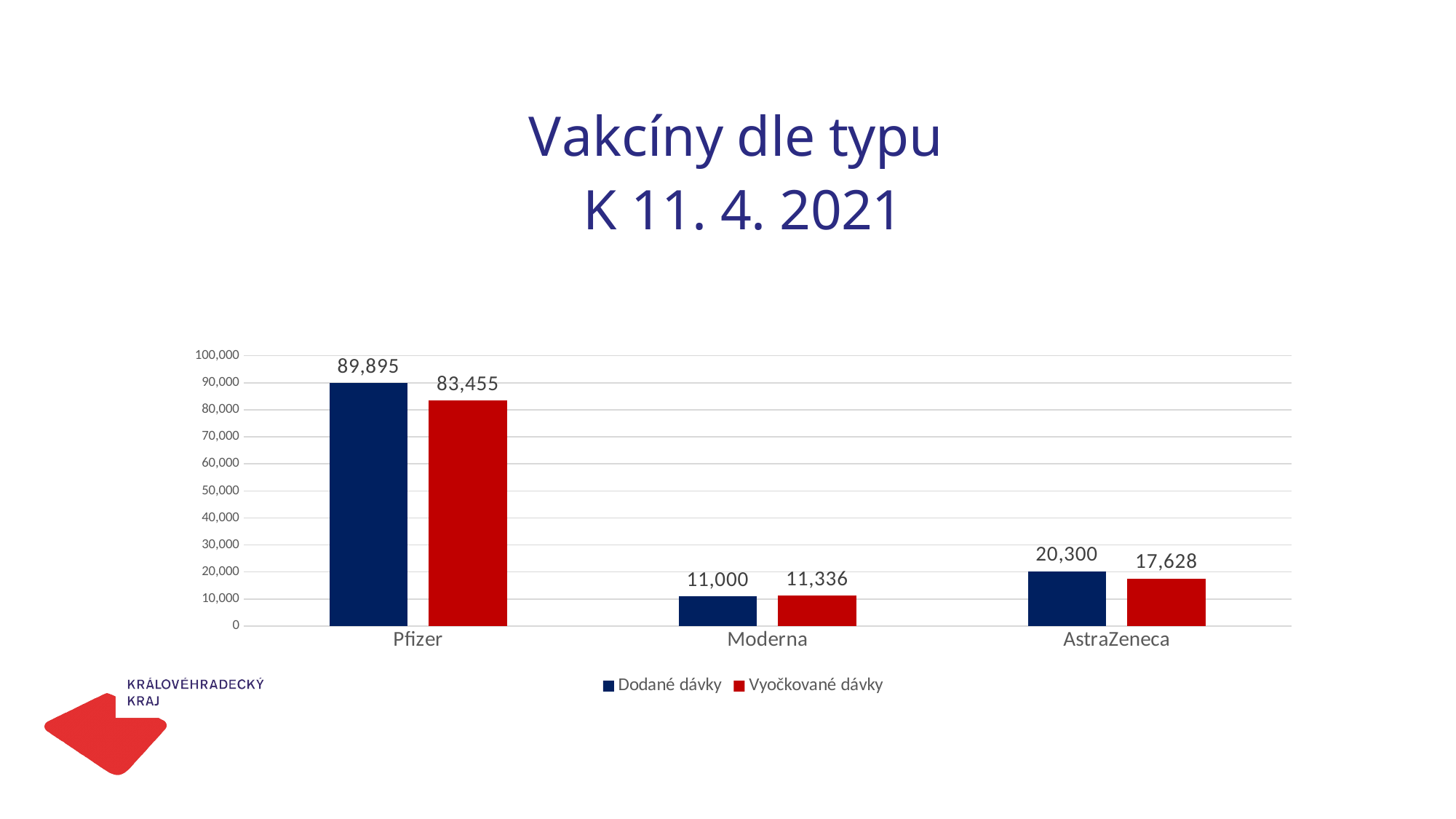
What is the difference between Dodané dávky and Vyočkované dávky for AstraZeneca? 2,672 What is the difference between Dodané dávky and Vyočkované dávky for Pfizer? 6,440 What is the value of Dodané dávky for Pfizer? 89,895 What is the value of Vyočkované dávky for AstraZeneca? 17,628 For Moderna, which is larger: Dodané dávky or Vyočkované dávky? Vyočkované dávky Which category has the lowest value for Vyočkované dávky? Moderna How many series does the legend list? 2 Which category has the highest value for Dodané dávky? Pfizer What is the title of the slide? Vakcíny dle typu K 11. 4. 2021 How many categories are shown on the x axis? 3 What kind of chart is shown on the slide? Bar chart What is the value of Vyočkované dávky for Moderna? 11,336